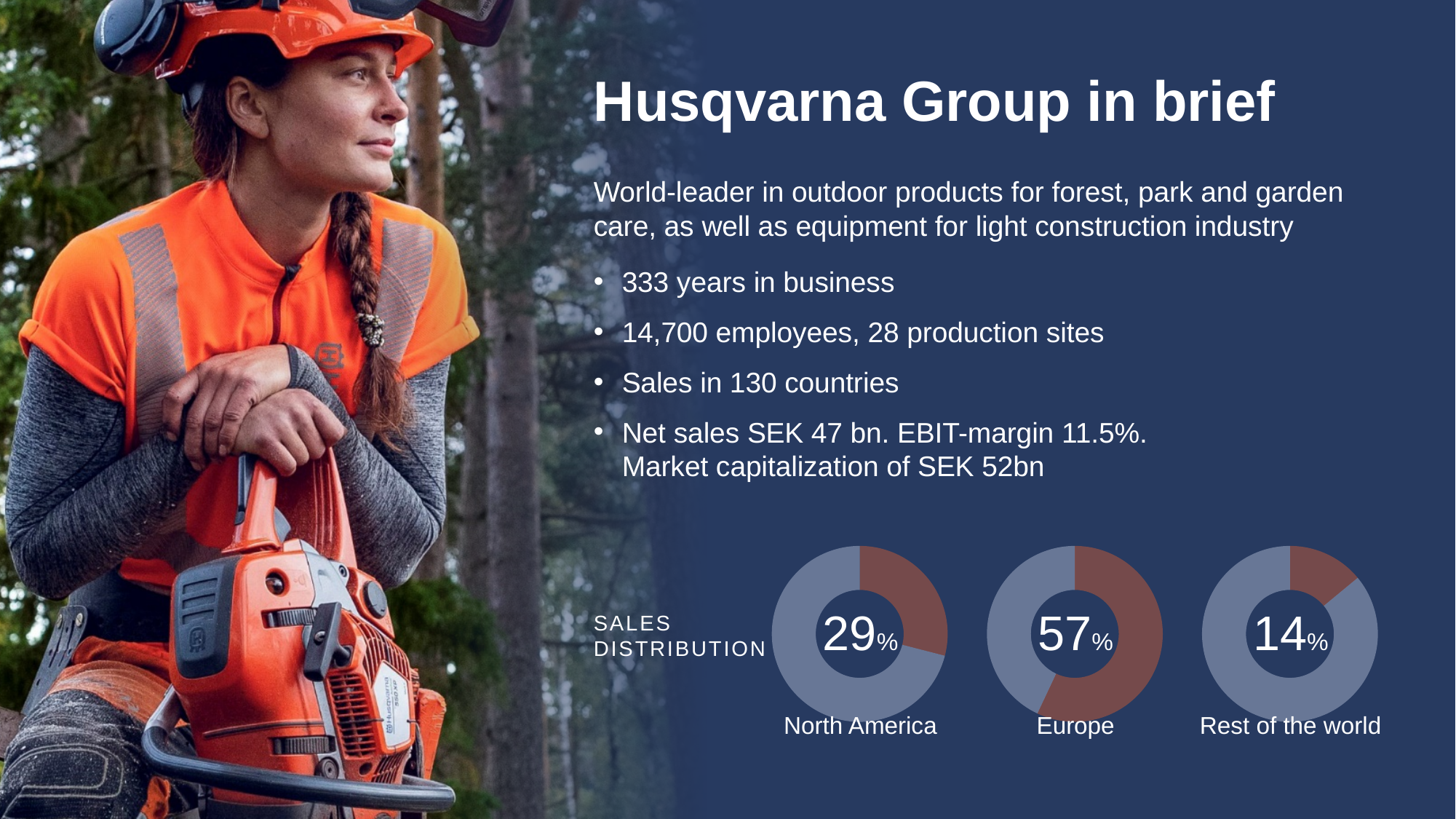
In the Sales distribution charts, how many percentage points higher is North America's share than Rest of the world's? 15 Among the Sales distribution charts, which region has the lowest share of sales? Rest of the world In the Sales distribution charts, which is larger: the share for North America or the share for Rest of the world? North America What is the label printed to the left of the three doughnut charts? Sales distribution In the Sales distribution charts, how many percentage points higher is Europe's share than North America's? 28 What is the combined share of North America and Europe in the Sales distribution charts? 86% In the Sales distribution charts, what share of sales comes from North America? 29% In the Sales distribution charts, what share of sales comes from Rest of the world? 14% How many regions are shown in the Sales distribution charts? 3 In the Sales distribution charts, what share of sales comes from Europe? 57% Among the Sales distribution charts, which region has the highest share of sales? Europe What kind of chart is used to show the Sales distribution for each region? Doughnut chart